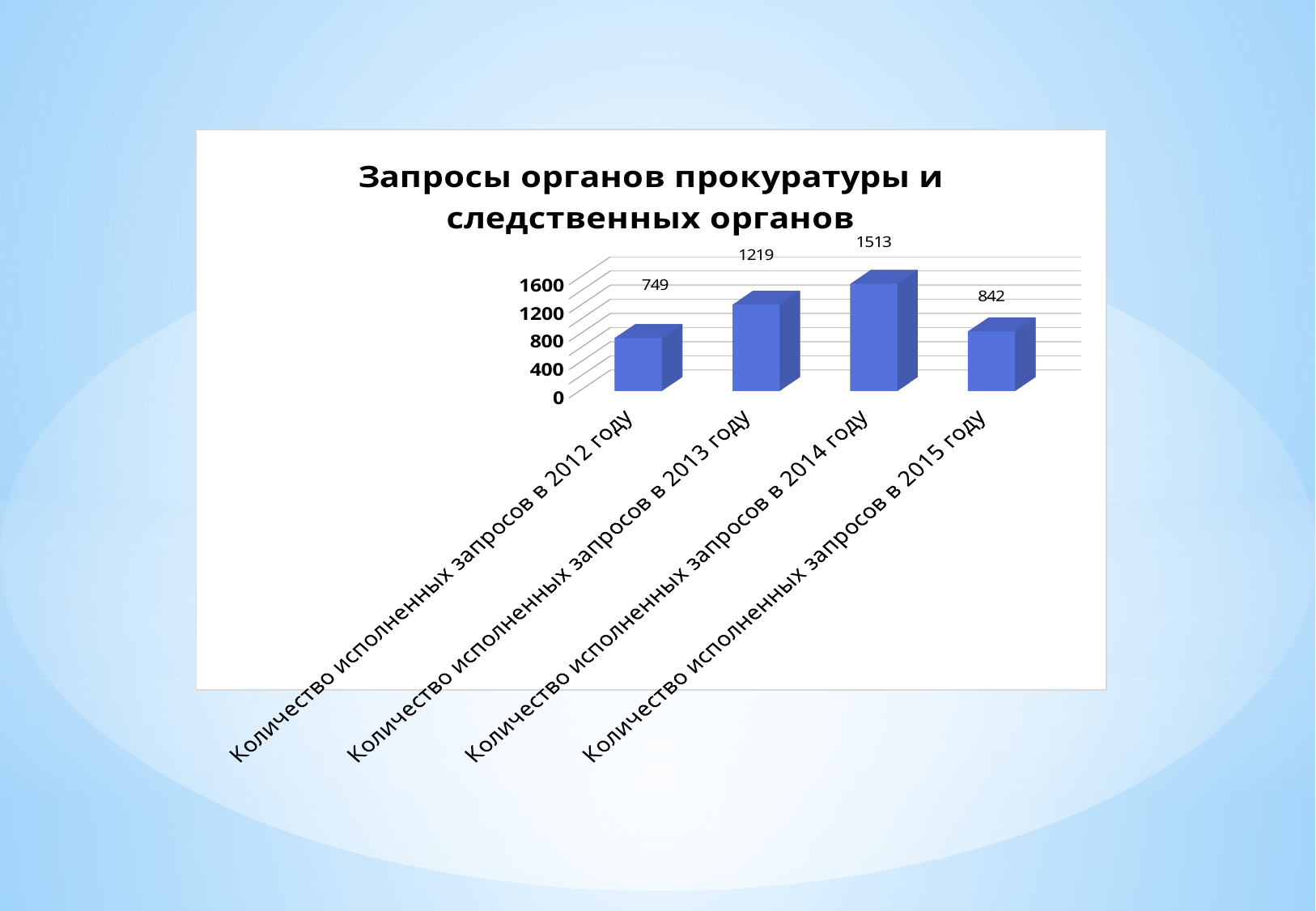
What is the value for 'Количество исполненных запросов в 2012 году'? 749 How many categories are shown in the chart? 4 What is the title of the chart? Запросы органов прокуратуры и следственных органов What is the value for 'Количество исполненных запросов в 2013 году'? 1219 What kind of chart is shown on the slide? Bar chart What is the value for 'Количество исполненных запросов в 2014 году'? 1513 What is the difference between the values for 2014 and 2013? 294 Which is larger, the value for 2013 or the value for 2015? 2013 What is the difference between the values for 2015 and 2012? 93 What is the value for 'Количество исполненных запросов в 2015 году'? 842 Which category has the highest value? Количество исполненных запросов в 2014 году Which category has the lowest value? Количество исполненных запросов в 2012 году